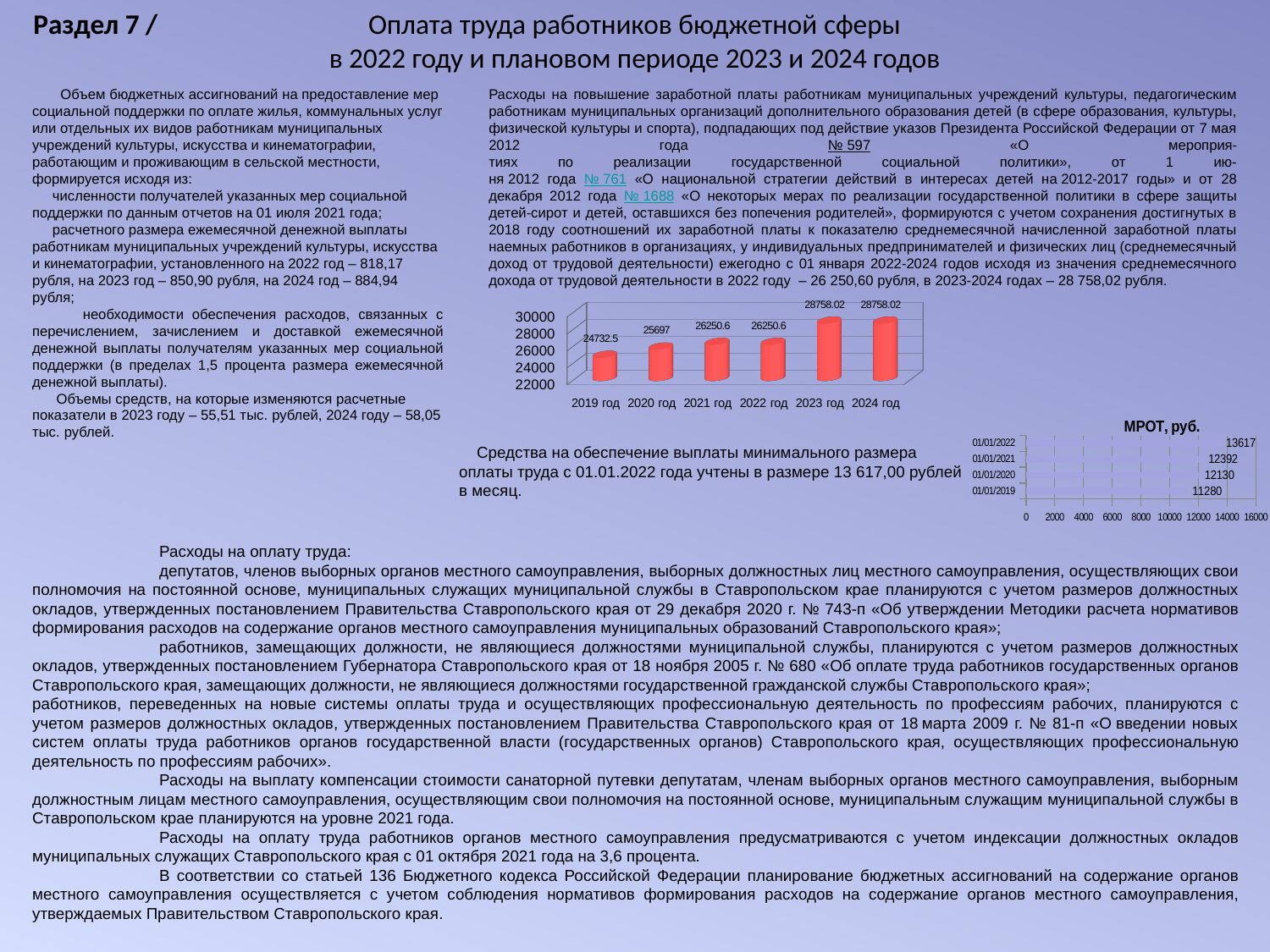
On the bar chart with years 2019–2024 (middle of the slide), what is the value for 2019 год? 24732.5 On the bar chart with years 2019–2024, what is the value for 2021 год? 26250.6 On the bar chart with years 2019–2024, how many years are shown on the x axis? 6 On the bar chart with years 2019–2024, do the values rise or fall from 2019 to 2024? rise What kind of chart is the chart titled 'МРОТ, руб.'? bar chart On the chart titled 'МРОТ, руб.', which date has the highest value? 01/01/2022 On the chart titled 'МРОТ, руб.', what is the value for 01/01/2019? 11280 On the bar chart with years 2019–2024, which year has the lowest value? 2019 год On the bar chart with years 2019–2024, what is the difference between the values for 2023 год and 2022 год? 2507.42 On the chart titled 'МРОТ, руб.', what is the value for 01/01/2022? 13617 On the chart titled 'МРОТ, руб.', what is the difference between the values for 01/01/2021 and 01/01/2020? 262 On the bar chart with years 2019–2024, what is the value for 2024 год? 28758.02